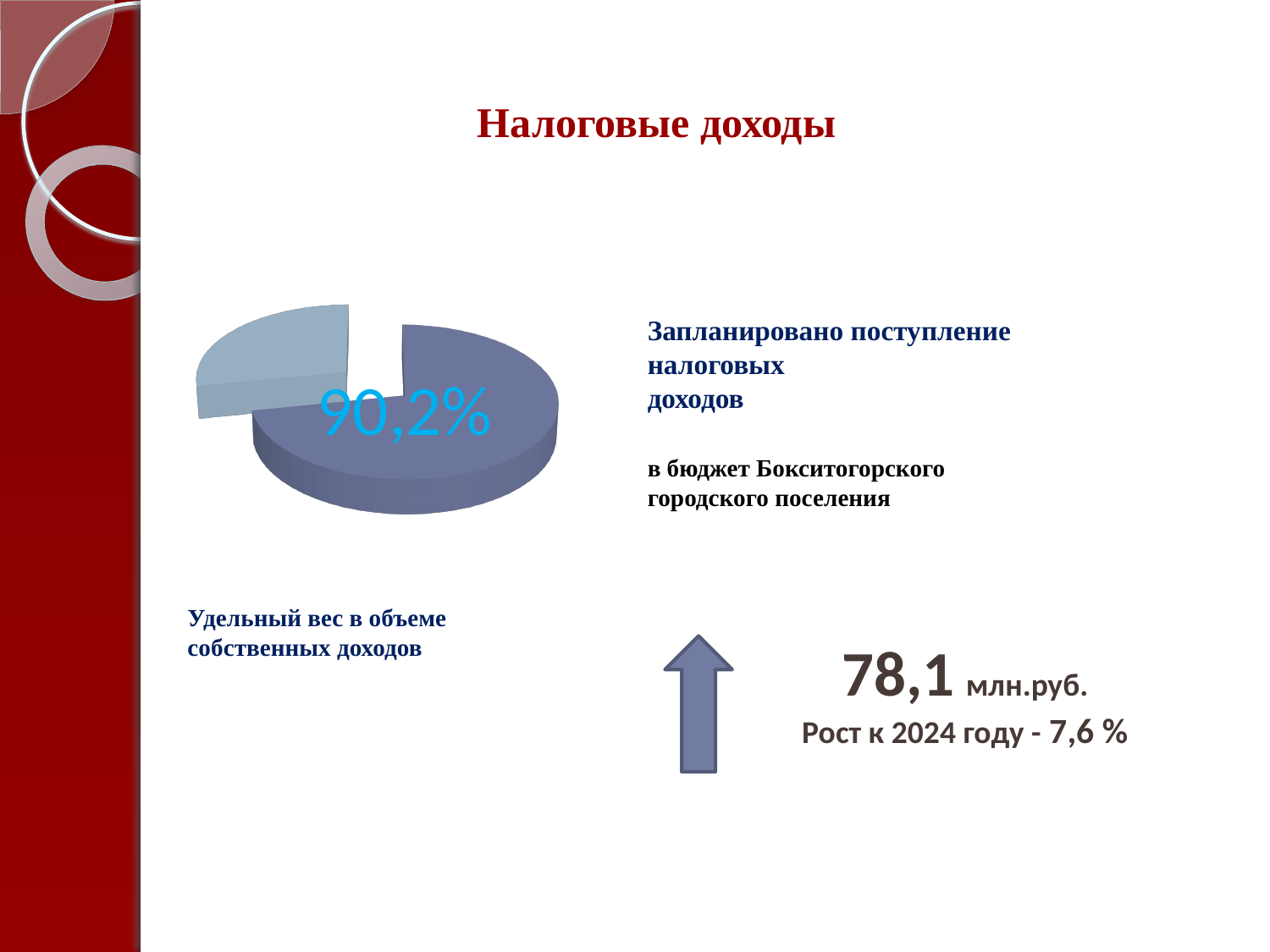
What percentage is printed on the large slice of the pie chart? 90,2% How many slices does the pie chart have? 2 What kind of chart is shown on the slide? pie chart What share of the pie does the labelled slice represent? 90,2% What colour is the slice labelled 90,2%? dark blue What is the title shown above the pie chart on the slide? Налоговые доходы Which slice of the pie chart is larger, the dark blue one or the light blue one? the dark blue one